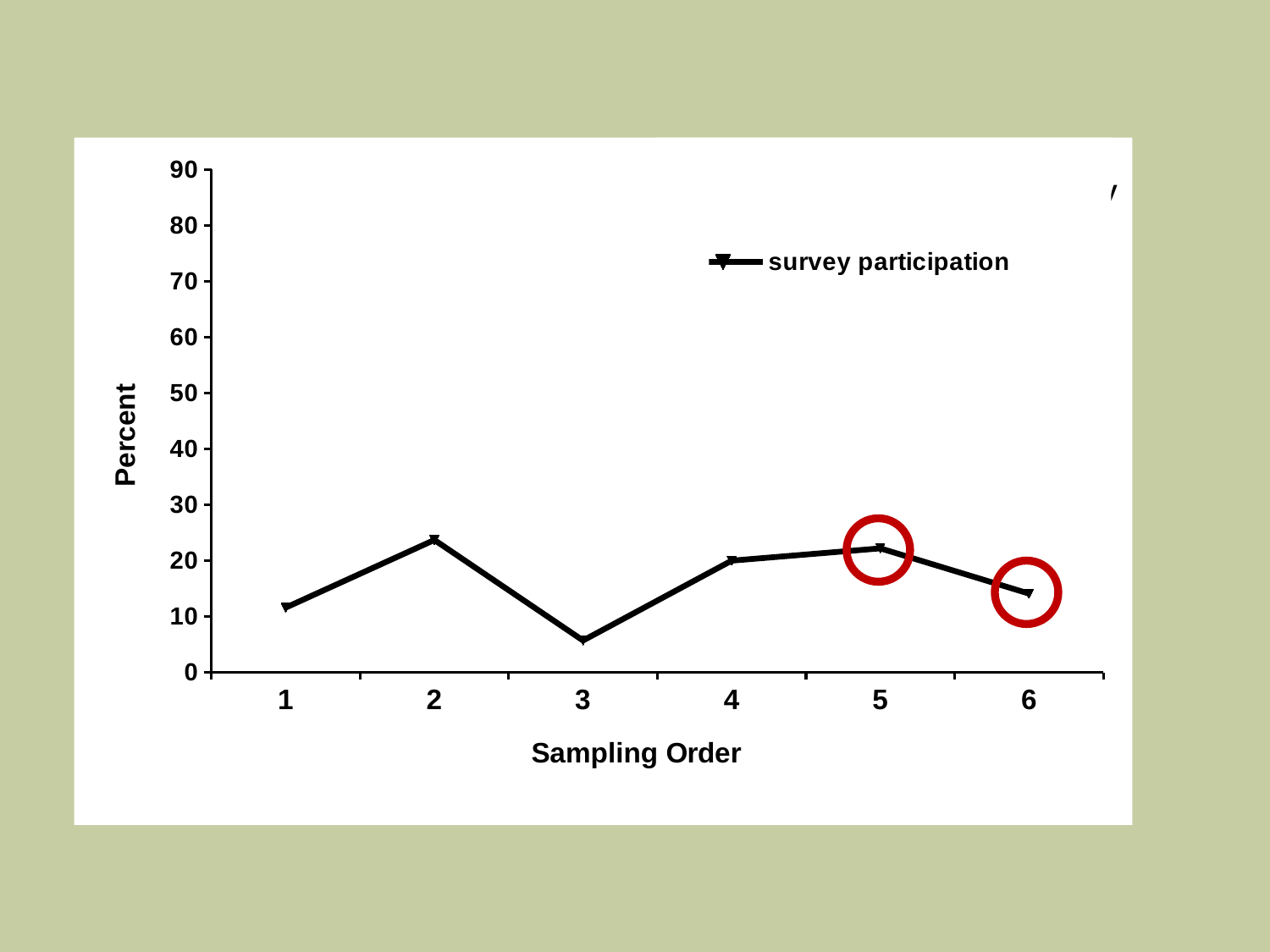
Which sampling order has the lowest survey participation? 3 Is the survey participation value for sampling order 6 greater or less than 20? less How many series does the legend list? 1 Which has higher survey participation, sampling order 2 or sampling order 3? sampling order 2 What is the label on the x axis of the chart? Sampling Order Is the survey participation value for sampling order 2 greater or less than 20? greater How many sampling order points are plotted on the chart? 6 Is the survey participation value for sampling order 6 greater or less than 10? greater What kind of chart is shown on the slide? line chart What is the label on the y axis of the chart? Percent Does survey participation rise or fall from sampling order 5 to sampling order 6? fall